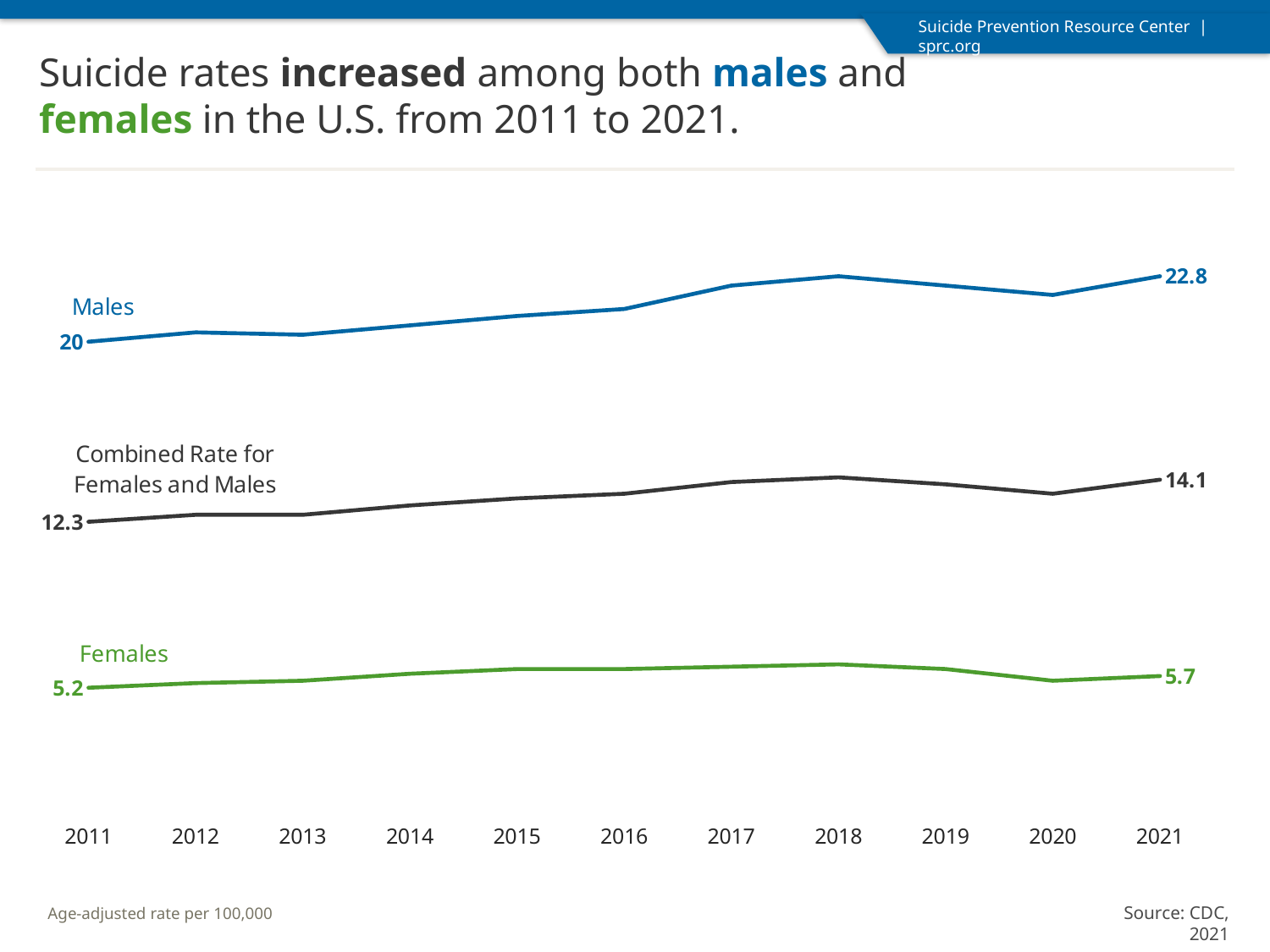
What was the suicide rate for males in 2011? 20 What was the combined rate for females and males in 2011? 12.3 By how much did the male suicide rate change from 2011 to 2021? 2.8 What type of chart is shown on the slide? Line chart By how much did the female suicide rate change from 2011 to 2021? 0.5 What was the suicide rate for males in 2021? 22.8 How many series are plotted on the chart? 3 What was the suicide rate for females in 2021? 5.7 Which series has the highest values across the chart? Males Which series has the lowest values across the chart? Females How many years are shown on the x axis? 11 What was the combined rate for females and males in 2021? 14.1